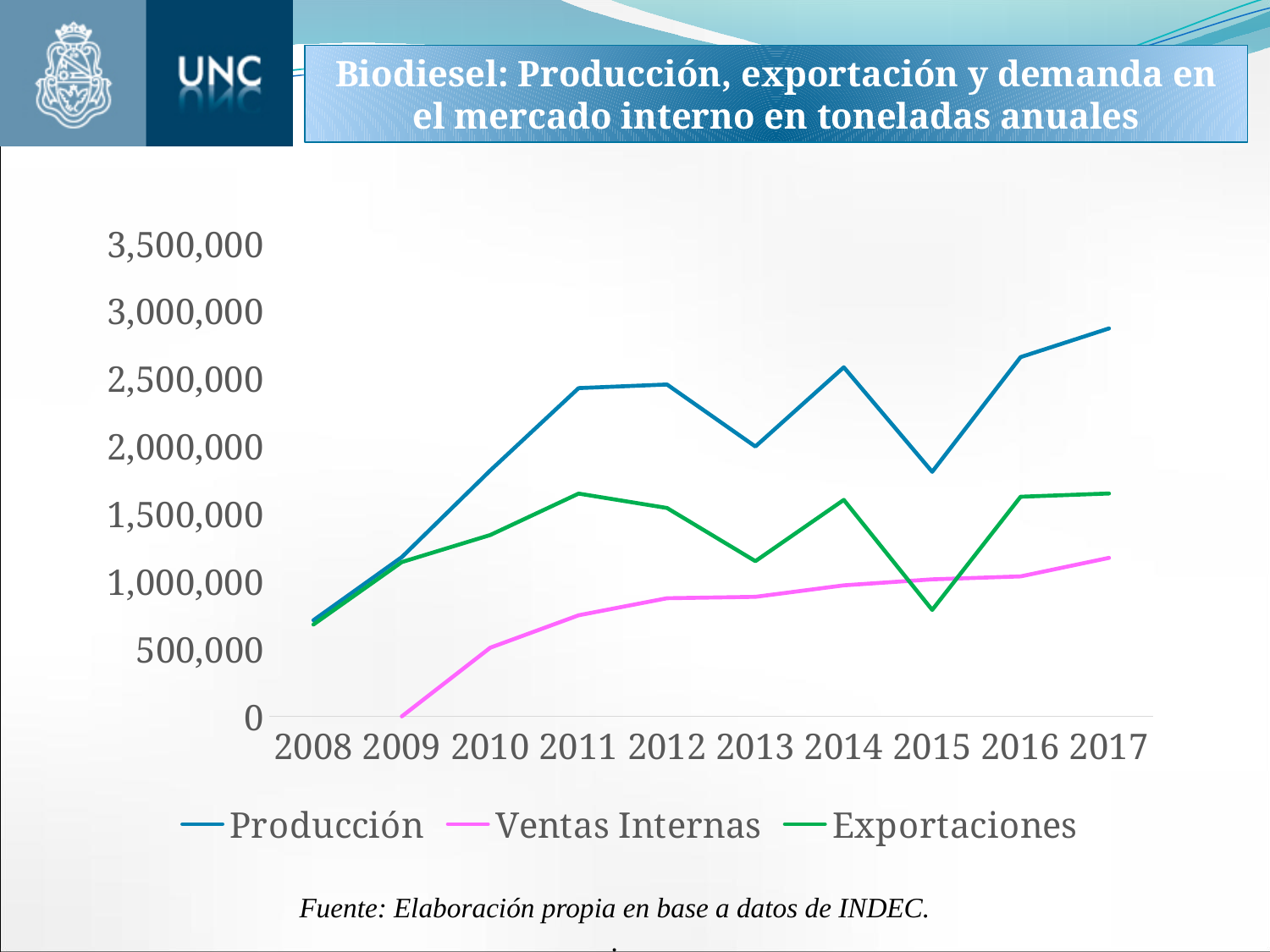
Is the value for Producción in 2017 greater or less than 2,500,000? greater Is the value for Exportaciones in 2015 greater or less than 1,000,000? less In which year is Producción lowest? 2008 How many years are shown on the x axis? 10 In which year is Producción highest? 2017 How many series does the legend list? 3 Do the values for Ventas Internas rise or fall from 2009 to 2017? rise In 2014, which is larger: Producción or Exportaciones? Producción What kind of chart is shown on the slide? line chart Is the value for Producción in 2011 greater or less than 2,000,000? greater In 2015, which is larger: Exportaciones or Ventas Internas? Ventas Internas What colour is the Exportaciones line? green